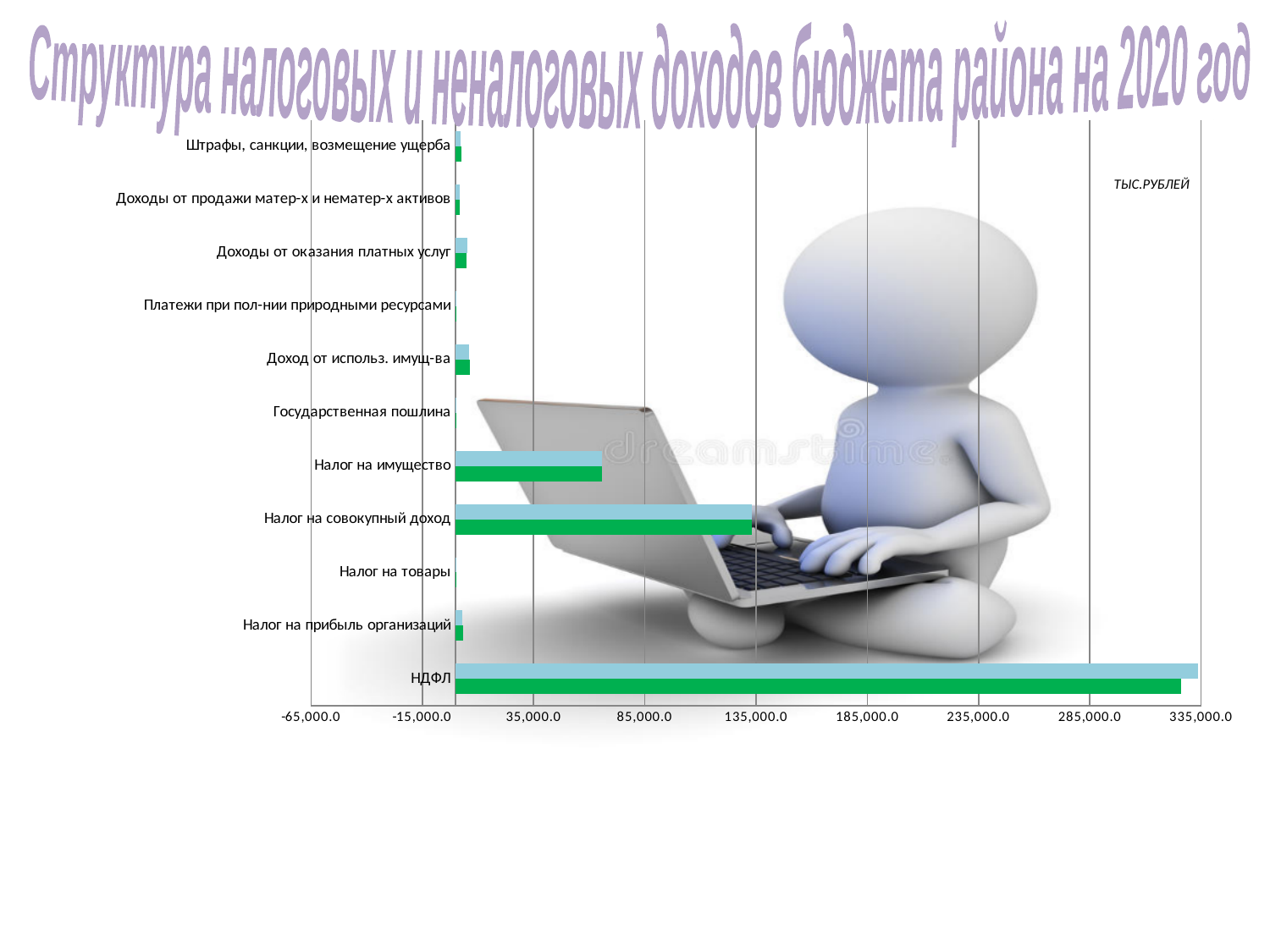
Is the light blue bar for НДФЛ greater or less than 285,000.0? greater Is the green bar for Налог на прибыль организаций greater or less than 35,000.0? less Is the light blue bar for Налог на имущество greater or less than 85,000.0? less How many data series (bars per category) are plotted in the chart? 2 What kind of chart is shown on the slide? bar chart Which is larger, the value for Налог на имущество or the value for Налог на прибыль организаций? Налог на имущество Which category has the highest value in the chart? НДФЛ How many categories are listed on the vertical axis of the chart? 11 What unit label is shown in the upper right of the chart? ТЫС.РУБЛЕЙ Which is larger, the value for НДФЛ or the value for Налог на совокупный доход? НДФЛ